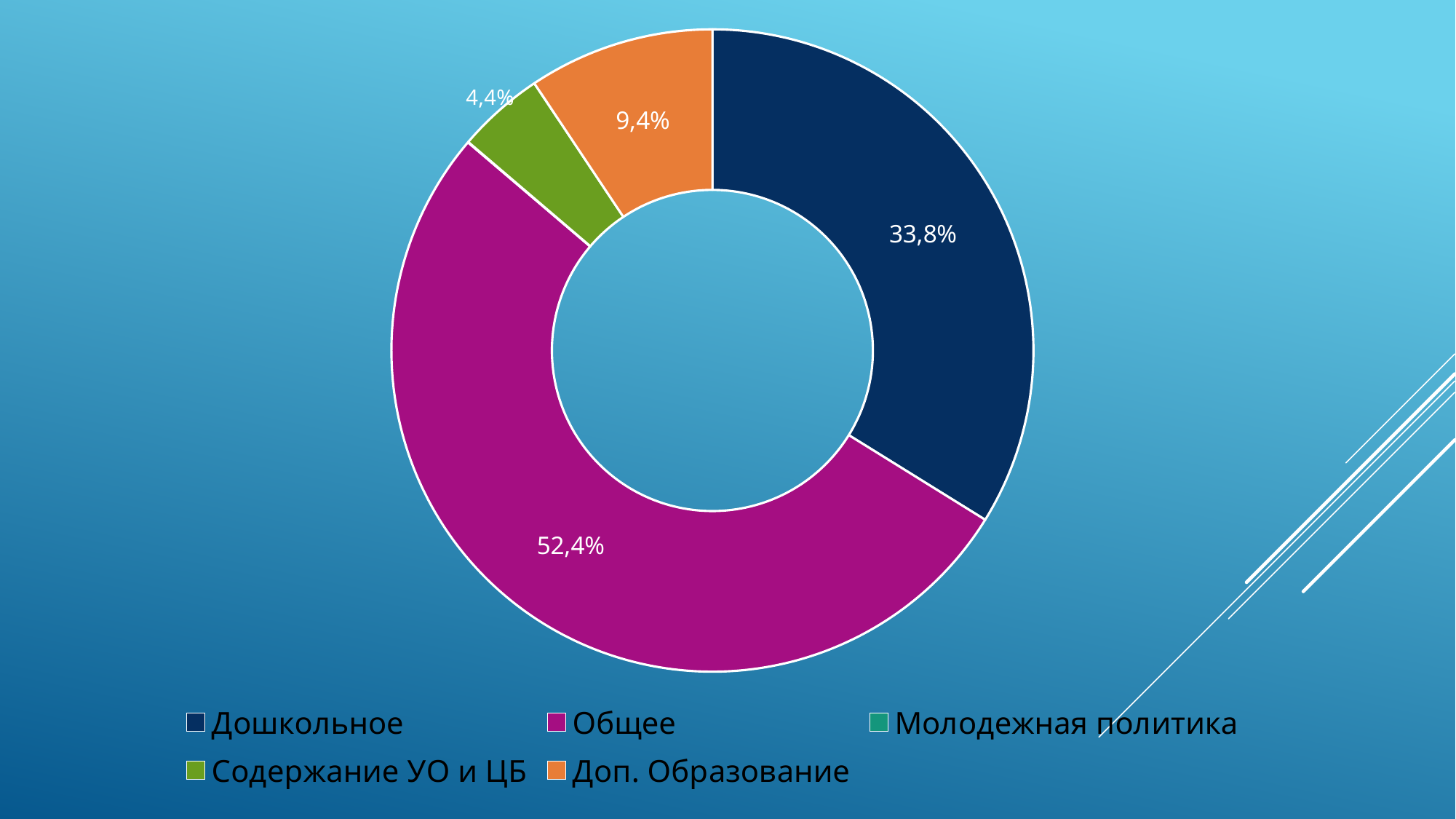
By how many percentage points does Общее exceed Дошкольное? 18,6 What percentage is shown for the Доп. Образование slice? 9,4% Which is larger, the Доп. Образование slice or the Содержание УО и ЦБ slice? Доп. Образование How many entries does the legend list? 5 Which category has the largest slice of the chart? Общее What kind of chart is shown on the slide? Doughnut (pie) chart What percentage is shown for the Дошкольное slice? 33,8% What is the combined share of Дошкольное and Общее? 86,2% What colour is used for the Общее slice? Magenta (purple) Which of the labelled slices is the smallest? Содержание УО и ЦБ What percentage is shown for the Содержание УО и ЦБ slice? 4,4% What percentage is shown for the Общее slice? 52,4%